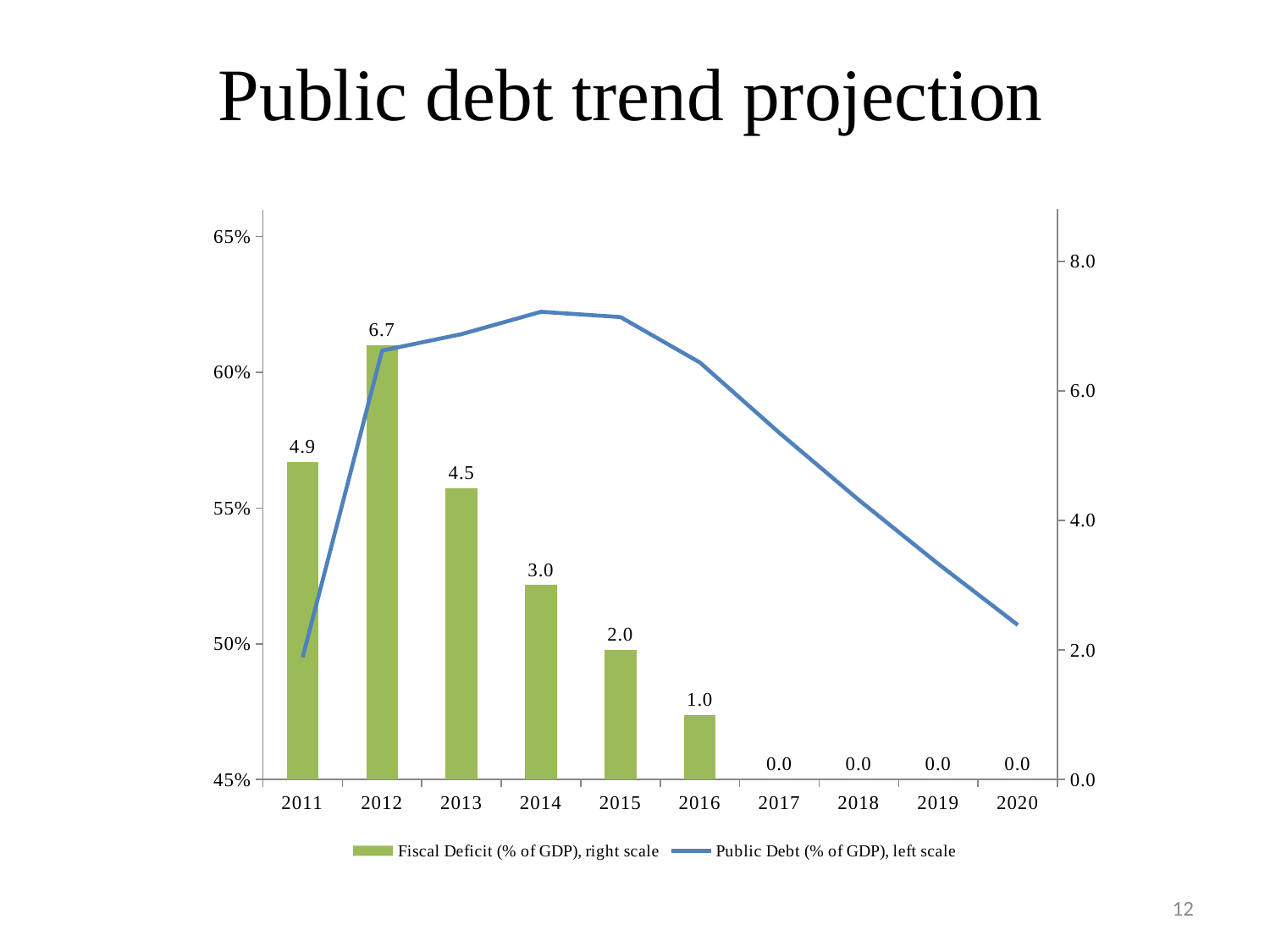
How many series does the legend list? 2 How many years are shown on the x axis? 10 What is the Fiscal Deficit (% of GDP) value for 2012? 6.7 What is the Fiscal Deficit (% of GDP) value for 2014? 3.0 Is the Public Debt (% of GDP) value for 2011 greater or less than 50%? less What is the title of the slide? Public debt trend projection What is the difference between the Fiscal Deficit values for 2011 and 2013? 0.4 Which year has the highest Fiscal Deficit (% of GDP)? 2012 Does the Public Debt (% of GDP) line rise or fall from 2015 to 2020? fall Which is larger, the Fiscal Deficit for 2013 or for 2015? 2013 Is the Public Debt (% of GDP) value for 2014 greater or less than 60%? greater Does the Fiscal Deficit (% of GDP) rise or fall from 2012 to 2016? fall